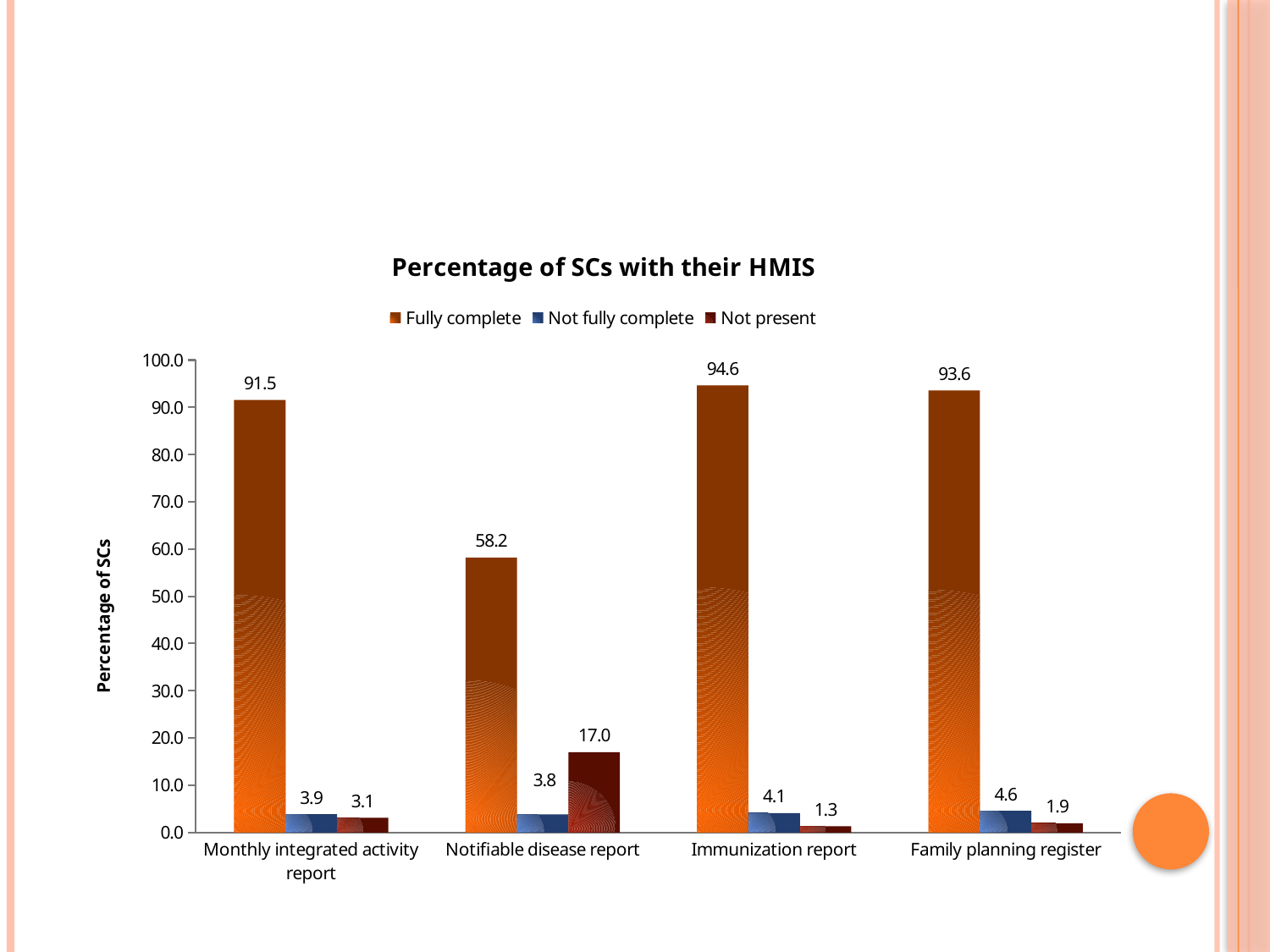
Which category has the lowest 'Fully complete' value? Notifiable disease report Which category has the highest 'Not present' value? Notifiable disease report What is the difference between the 'Fully complete' values for Immunization report and Notifiable disease report? 36.4 What is the 'Fully complete' value for Notifiable disease report? 58.2 What is the 'Not fully complete' value for Family planning register? 4.6 How many series does the legend list? 3 Which is larger: the 'Not present' value for Monthly integrated activity report or for Family planning register? Monthly integrated activity report What kind of chart is shown? Bar chart Which category has the highest 'Fully complete' value? Immunization report How many categories are shown on the x axis? 4 What is the 'Not present' value for Immunization report? 1.3 What is the title of the chart? Percentage of SCs with their HMIS